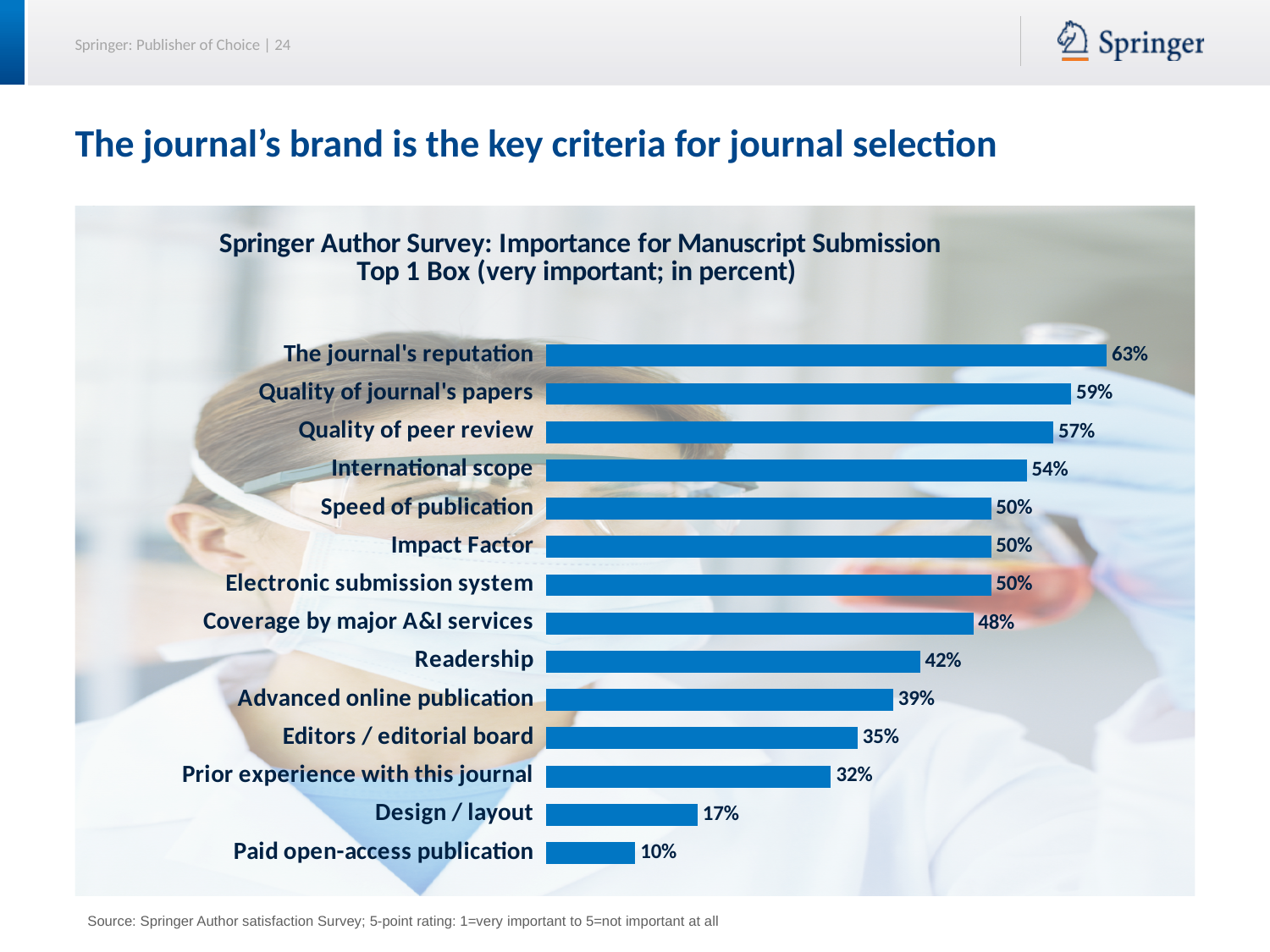
What is the value for The journal's reputation? 63% What is the value for Paid open-access publication? 10% What is the title of the chart? Springer Author Survey: Importance for Manuscript Submission Top 1 Box (very important; in percent) Which category has the lowest value? Paid open-access publication How many categories are shown in the chart? 14 What is the difference between the values for International scope and Readership? 12% What is the value for Quality of peer review? 57% Which is larger, the value for Advanced online publication or the value for Editors / editorial board? Advanced online publication What is the value for Readership? 42% Which category has the highest value? The journal's reputation What kind of chart is shown on the slide? Bar chart What is the difference between the values for The journal's reputation and Paid open-access publication? 53%